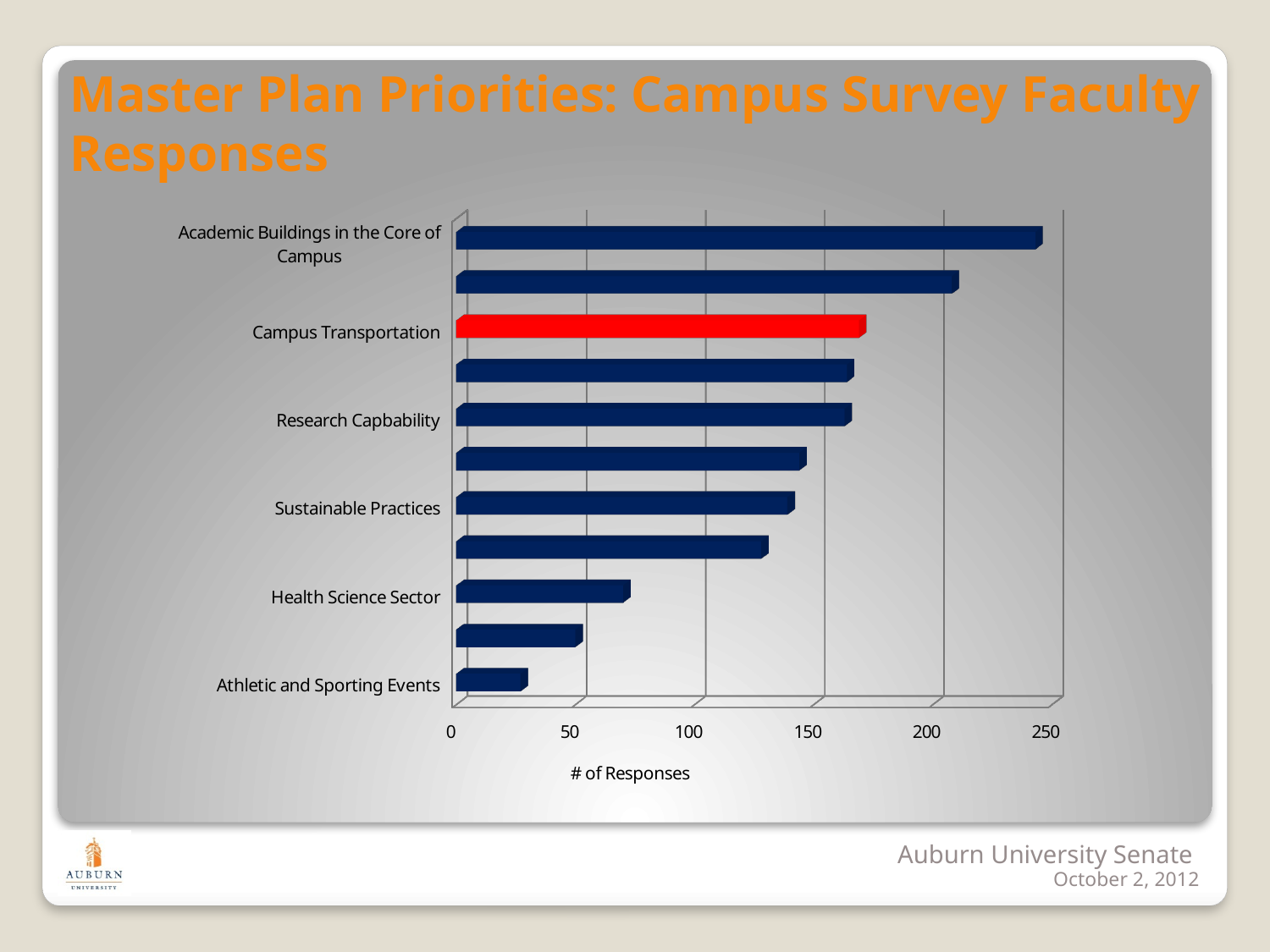
How many bars are plotted in the chart? 11 Is the value for Campus Transportation greater or less than 150? greater Is the value for Academic Buildings in the Core of Campus greater or less than 200? greater Is the value for Health Science Sector greater or less than 100? less Which labeled category has the lowest number of responses? Athletic and Sporting Events Which has more responses, Campus Transportation or Sustainable Practices? Campus Transportation What kind of chart is shown on the slide? bar chart Which category's bar is colored red? Campus Transportation Which labeled category has the highest number of responses? Academic Buildings in the Core of Campus What is the title of the horizontal axis? # of Responses